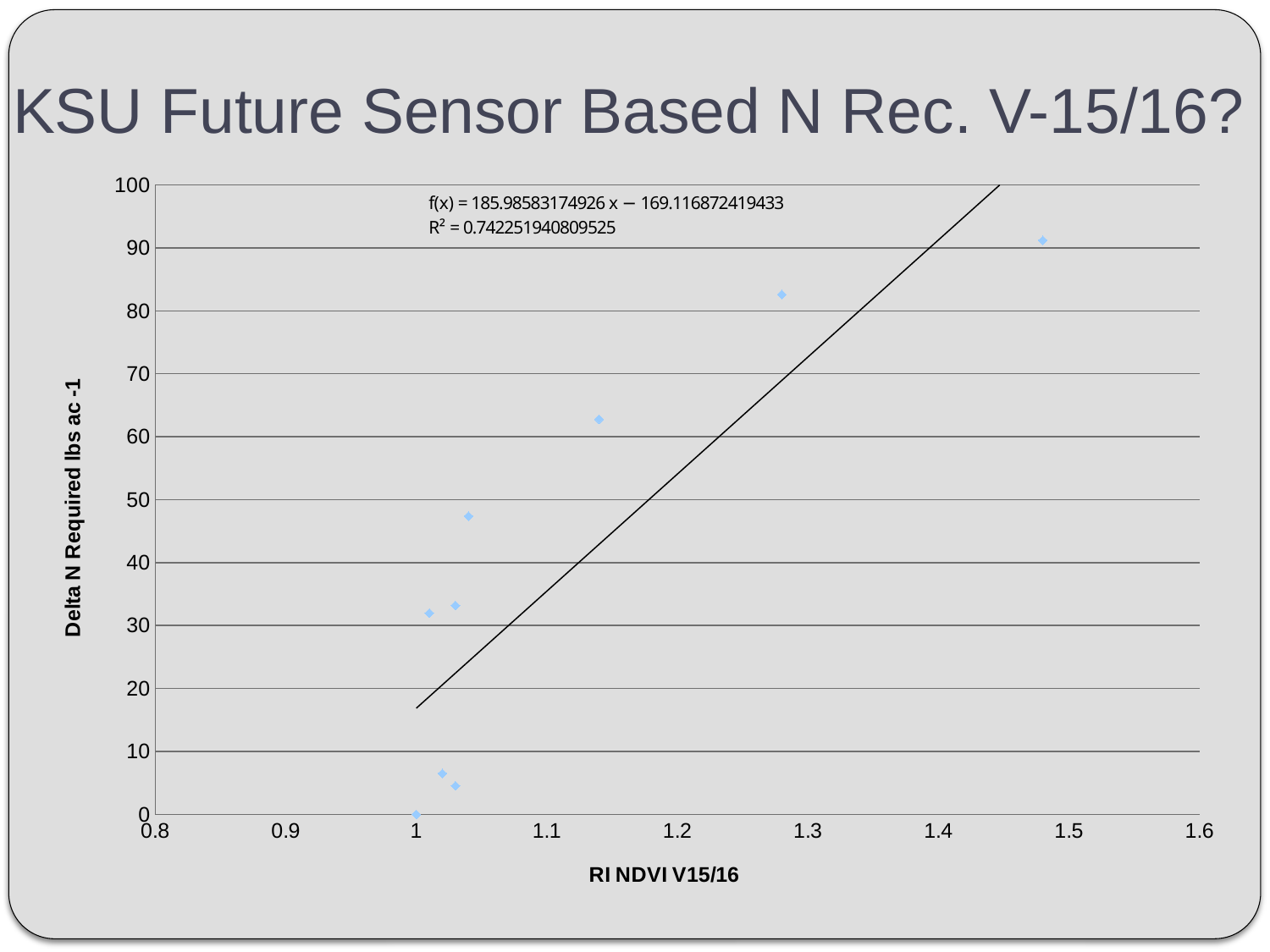
Is the Delta N Required value for the point with the highest RI NDVI (near 1.48) greater or less than 80? greater What is the title of the chart's x axis? RI NDVI V15/16 What is the trendline equation printed on the chart? f(x) = 185.98583174926 x − 169.116872419433 What is the title of the chart's y axis? Delta N Required lbs ac -1 Is the Delta N Required value for the point near RI NDVI 1.14 greater or less than 70? less Is the Delta N Required value for the point near RI NDVI 1.28 greater or less than 70? greater What is the lowest Delta N Required value plotted on the chart? 0 What kind of chart is shown on the slide? scatter chart Do the Delta N Required values generally rise or fall as RI NDVI V15/16 increases? rise What is the R² value printed on the chart? 0.742251940809525